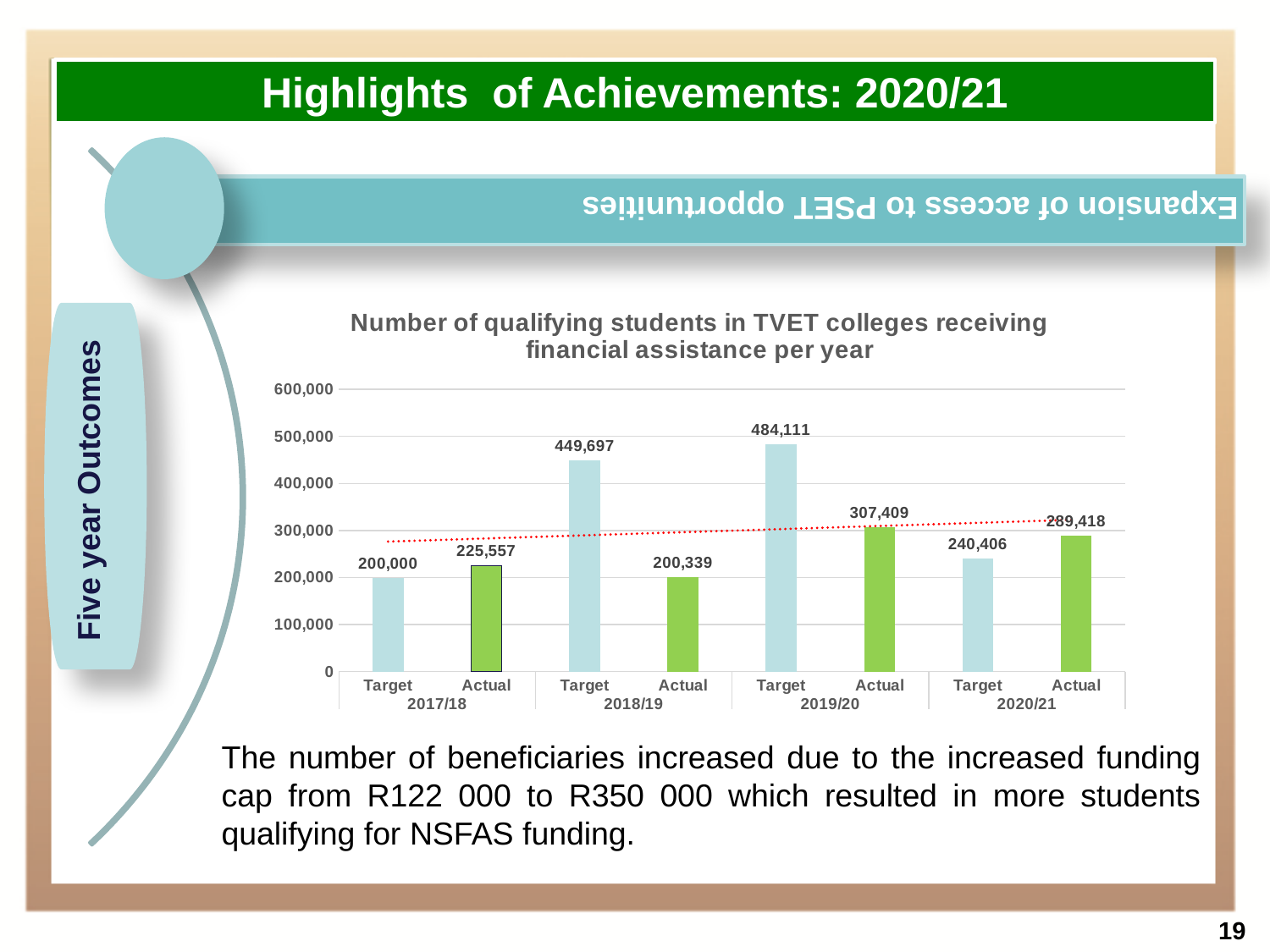
What is the difference between the Target and Actual values for 2018/19? 249,358 What is the difference between the Actual values for 2019/20 and 2020/21? 17,991 What is the title of the chart? Number of qualifying students in TVET colleges receiving financial assistance per year What is the Target value for 2018/19? 449,697 Which is larger, the Actual value for 2020/21 or the Target value for 2020/21? Actual 2020/21 How many bars are plotted in the chart? 8 What is the Actual value for 2020/21? 289,418 What kind of chart is shown on the slide? Bar chart Which bar has the lowest value? Target 2017/18 What is the Actual value for 2019/20? 307,409 What is the Target value for 2017/18? 200,000 Which bar has the highest value? Target 2019/20